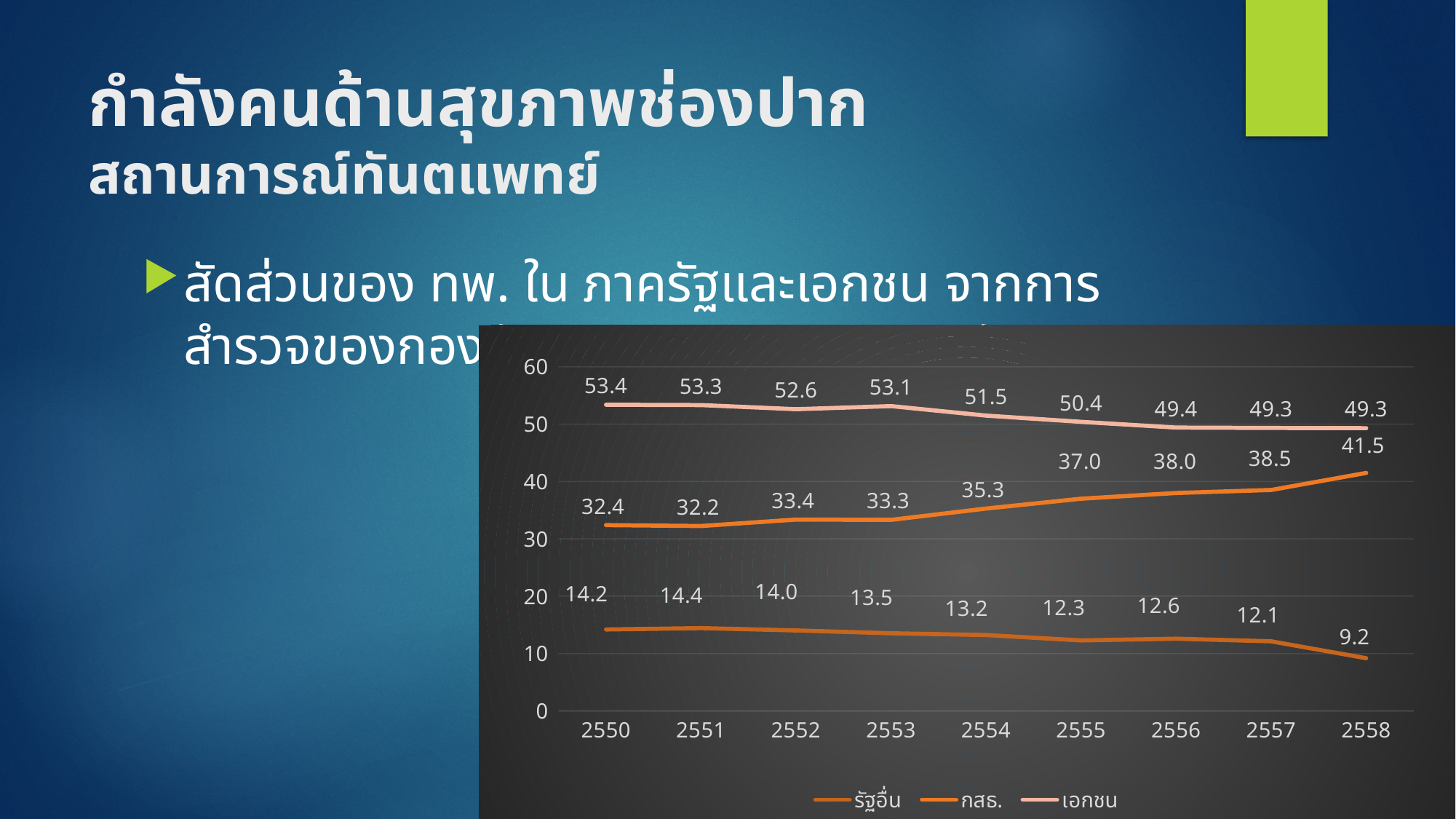
How many years are shown on the x axis? 9 What is the value for รัฐอื่น in 2556? 12.6 In which year is the value for กสธ. highest? 2558 In which year is the value for รัฐอื่น lowest? 2558 Does the value for กสธ. rise or fall from 2550 to 2558? rise How many series does the legend list? 3 What is the difference between the เอกชน value and the กสธ. value in 2558? 7.8 Which series has the larger value in 2554, กสธ. or รัฐอื่น? กสธ. What kind of chart is shown on the slide? line chart Which series is drawn with the light pink line? เอกชน What is the value for เอกชน in 2550? 53.4 What is the value for กสธ. in 2558? 41.5